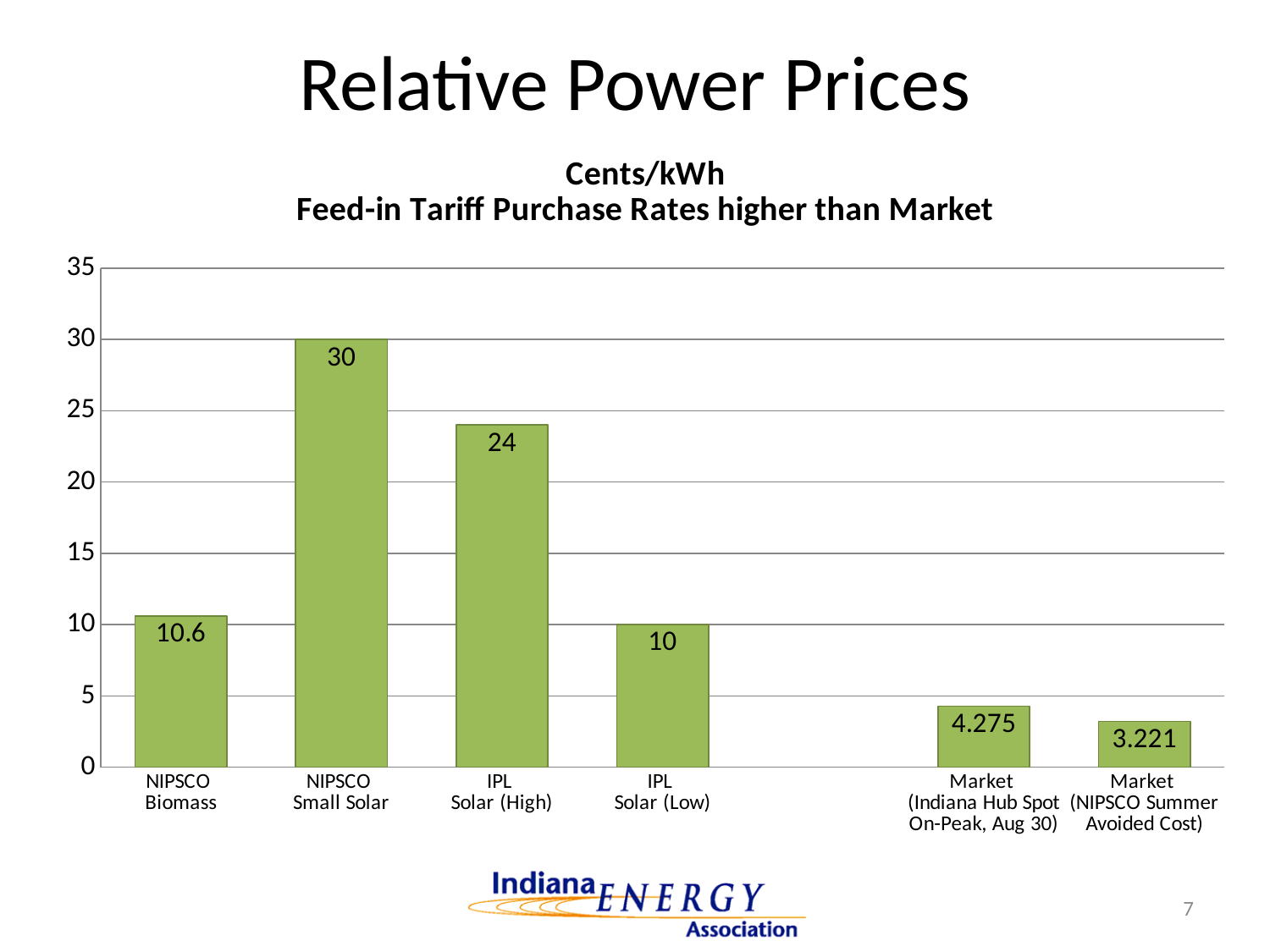
What is the difference between IPL Solar (High) and IPL Solar (Low)? 14 What is the difference between NIPSCO Small Solar and IPL Solar (High)? 6 How many bars are shown in the chart? 6 Which category has the lowest value? Market (NIPSCO Summer Avoided Cost) Which is larger, NIPSCO Biomass or IPL Solar (Low)? NIPSCO Biomass What is the value for Market (NIPSCO Summer Avoided Cost)? 3.221 Is the value for IPL Solar (High) greater or less than 20? greater What is the value for Market (Indiana Hub Spot On-Peak, Aug 30)? 4.275 What is the value for NIPSCO Biomass? 10.6 What is the value for NIPSCO Small Solar? 30 Which category has the highest value? NIPSCO Small Solar What kind of chart is shown on the slide? Bar chart